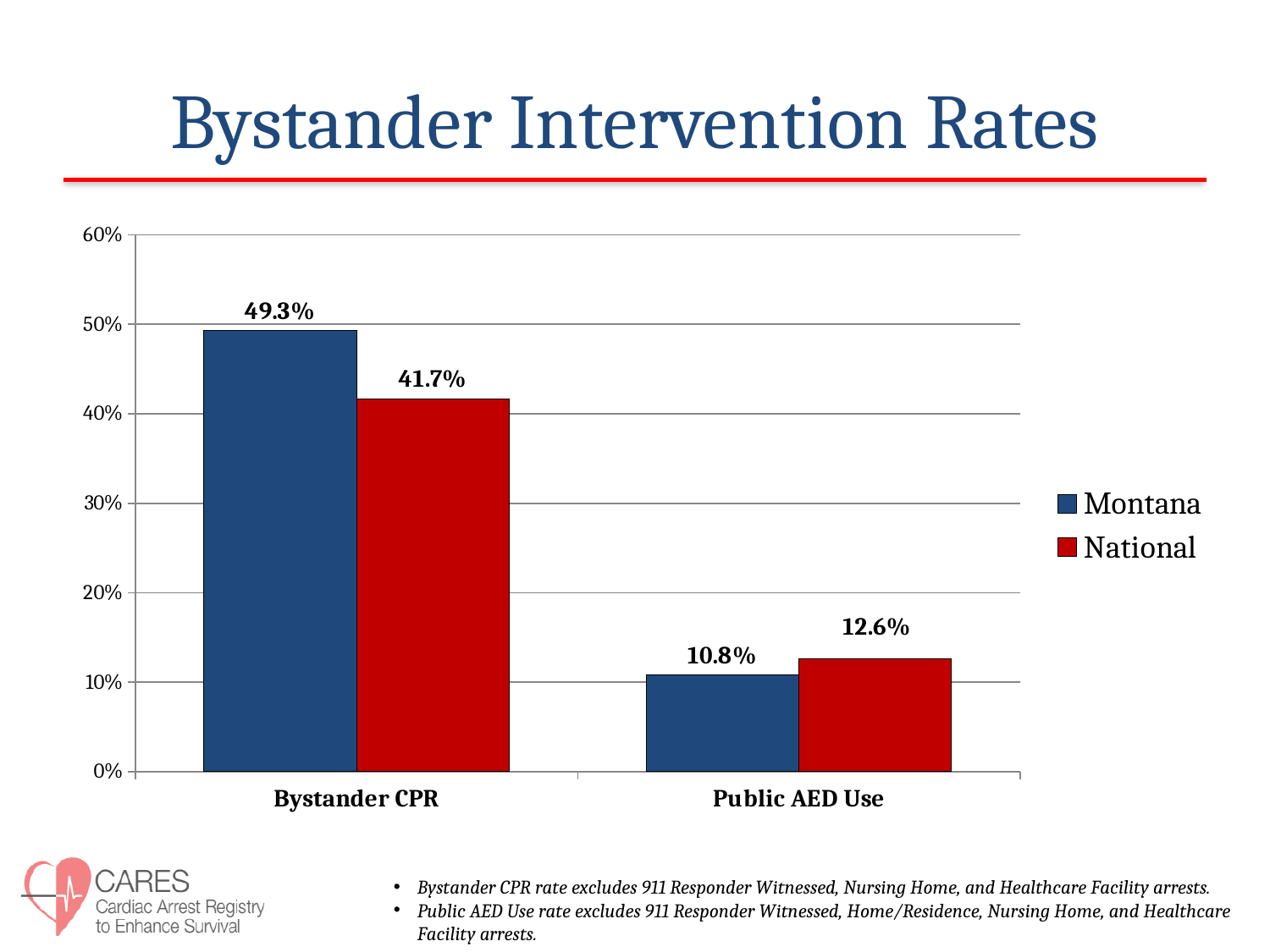
Is the Montana value for Bystander CPR greater or less than 40%? greater What is the National value for Bystander CPR? 41.7% What is the National value for Public AED Use? 12.6% Which category has the lowest National value? Public AED Use How many series does the legend list? 2 What kind of chart is shown on the slide? bar chart Which category has the highest Montana value? Bystander CPR What is the Montana value for Bystander CPR? 49.3% Which is larger for Public AED Use, Montana or National? National What is the difference between the Montana and National values for Bystander CPR? 7.6% How many categories are shown on the x axis? 2 What is the Montana value for Public AED Use? 10.8%